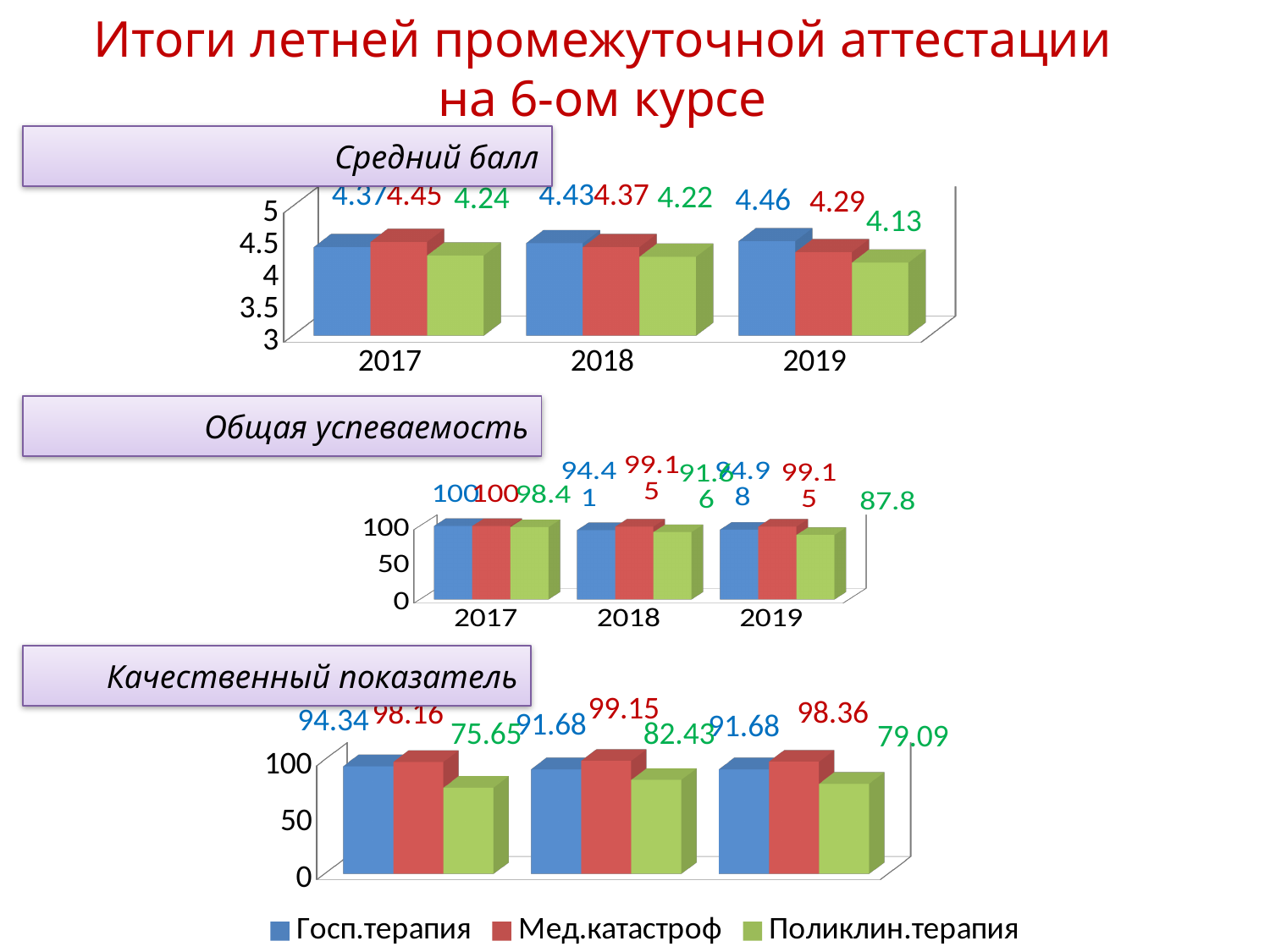
What type of chart is the 'Качественный показатель' chart? bar chart In the 'Качественный показатель' chart, which series has the lowest value in 2017? Поликлин.терапия In the 'Качественный показатель' chart, what is the value for Мед.катастроф in 2018? 99.15 In the 'Средний балл' chart, does the value for Поликлин.терапия rise or fall from 2017 to 2019? fall In the 'Средний балл' chart, what is the value for Госп.терапия in 2019? 4.46 In the 'Общая успеваемость' chart, what is the value for Поликлин.терапия in 2019? 87.8 In the 'Средний балл' chart, which year has the lowest value for Поликлин.терапия? 2019 In the 'Общая успеваемость' chart, what is the value for Поликлин.терапия in 2017? 98.4 In the 'Качественный показатель' chart, what is the difference between Госп.терапия and Поликлин.терапия in 2019? 12.59 In the 'Средний балл' chart, what is the value for Поликлин.терапия in 2017? 4.24 How many series does the legend list? 3 In the 'Средний балл' chart, what is the difference between Мед.катастроф and Поликлин.терапия in 2019? 0.16